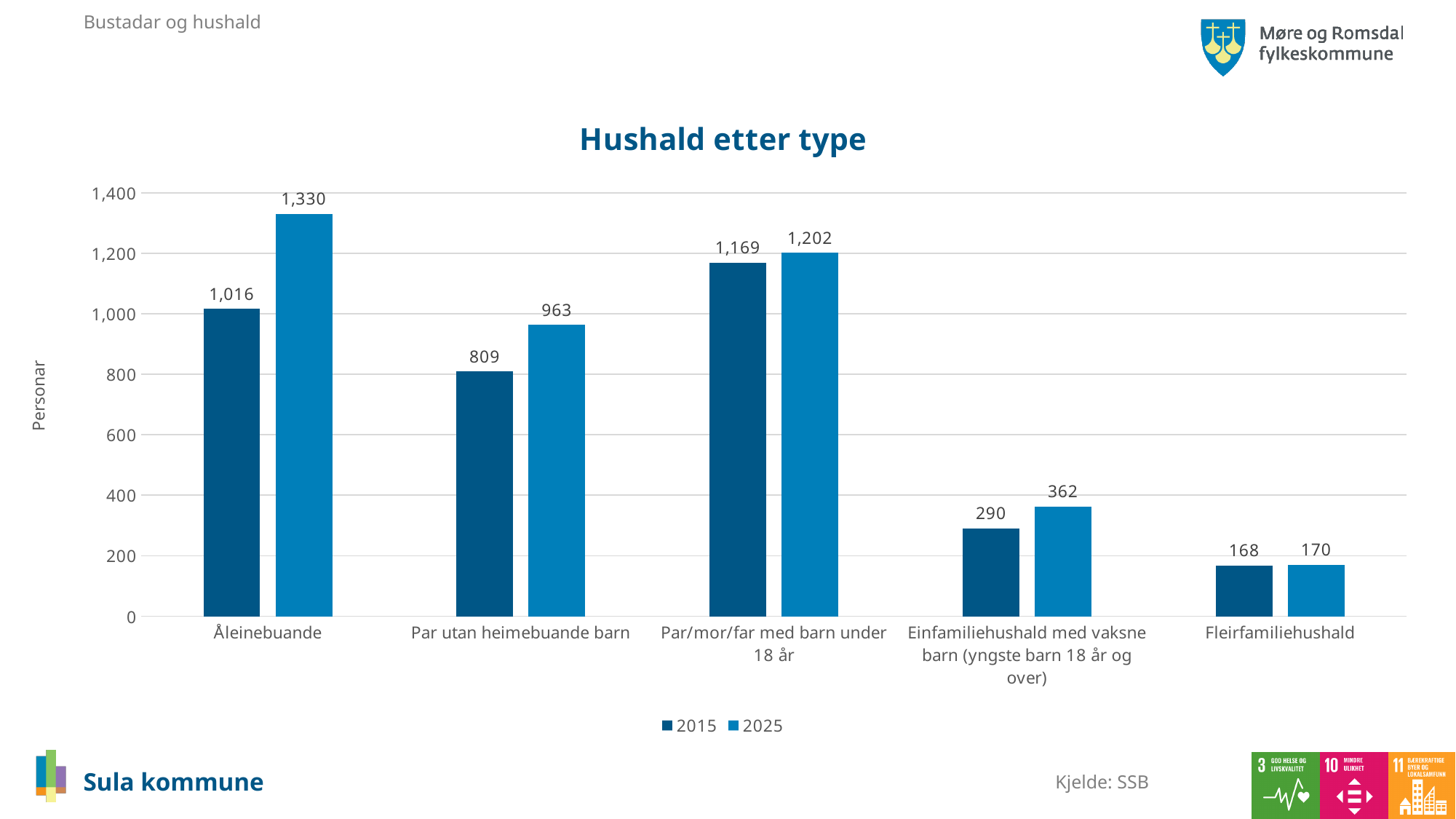
How many series does the legend list? 2 What is the title of the chart? Hushald etter type What is the value for Fleirfamiliehushald in 2025? 170 Which category has the lowest value in 2025? Fleirfamiliehushald Which category has the highest value in 2015? Par/mor/far med barn under 18 år What is the difference between the 2025 and 2015 values for Åleinebuande? 314 How many household categories are shown on the x axis? 5 What is the value for Par utan heimebuande barn in 2015? 809 Which is larger: the 2025 value for Par utan heimebuande barn or the 2015 value for Åleinebuande? 2015 value for Åleinebuande What is the value for Åleinebuande in 2025? 1,330 What kind of chart is shown? Bar chart What is the difference between the 2025 and 2015 values for Einfamiliehushald med vaksne barn (yngste barn 18 år og over)? 72